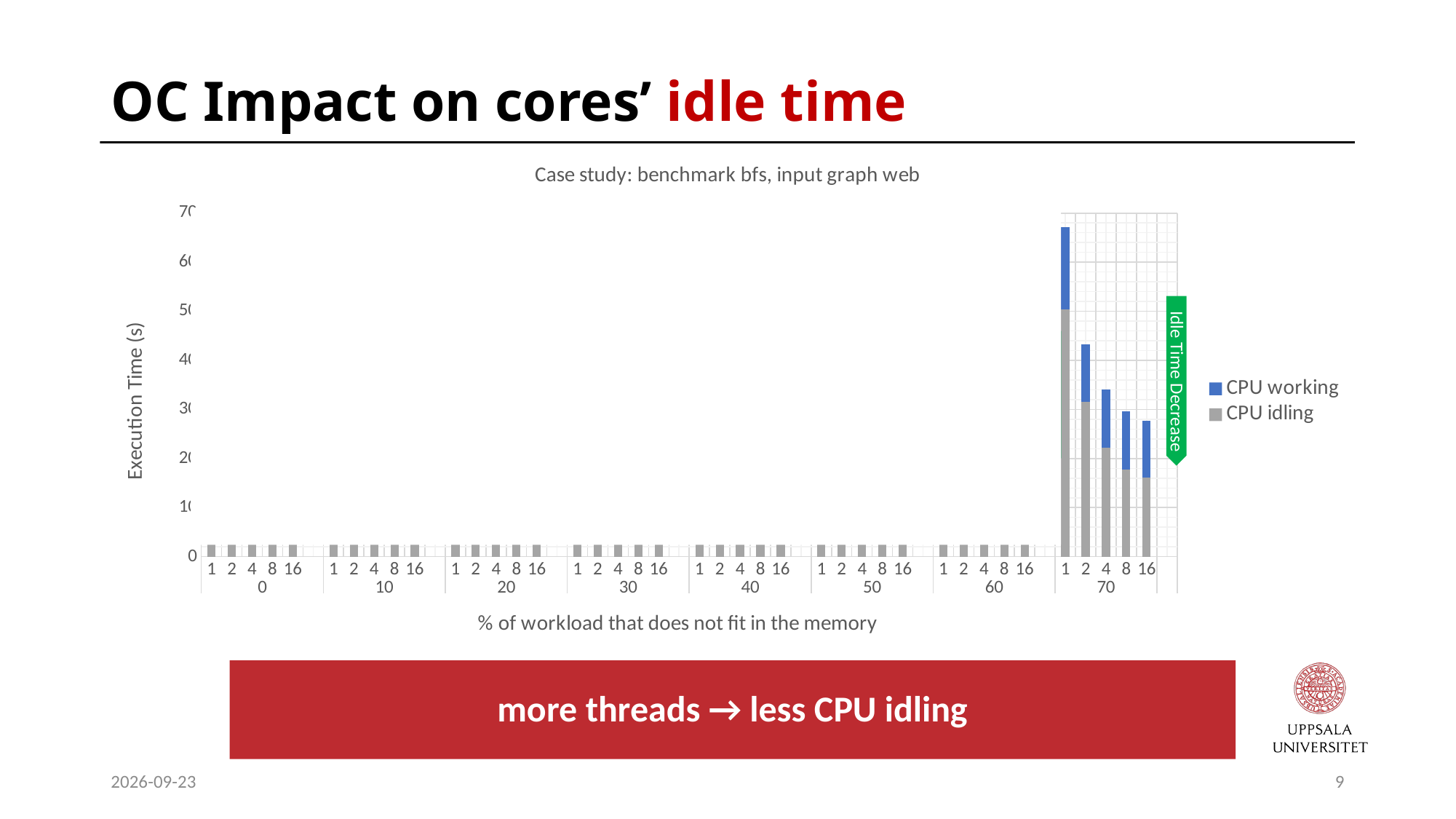
How many series does the chart legend list? 2 Is the CPU idling time for 16 threads at 70% workload greater or less than 20? less In the 70% workload group, which thread count has the lowest total execution time? 16 In the 70% workload group, which thread count has the highest total execution time? 1 How many workload-percentage groups are shown along the x axis? 8 What kind of chart is shown on the slide? Stacked bar chart What is the title of the chart? Case study: benchmark bfs, input graph web Within the 70% workload group, does total execution time rise or fall as the number of threads increases? Fall Is the total execution time for 1 thread at 0% workload greater or less than 10? less Is the total execution time for 1 thread at 70% workload greater or less than 60? greater What are the two series named in the chart legend? CPU working and CPU idling How many thread counts are plotted within each workload group? 5